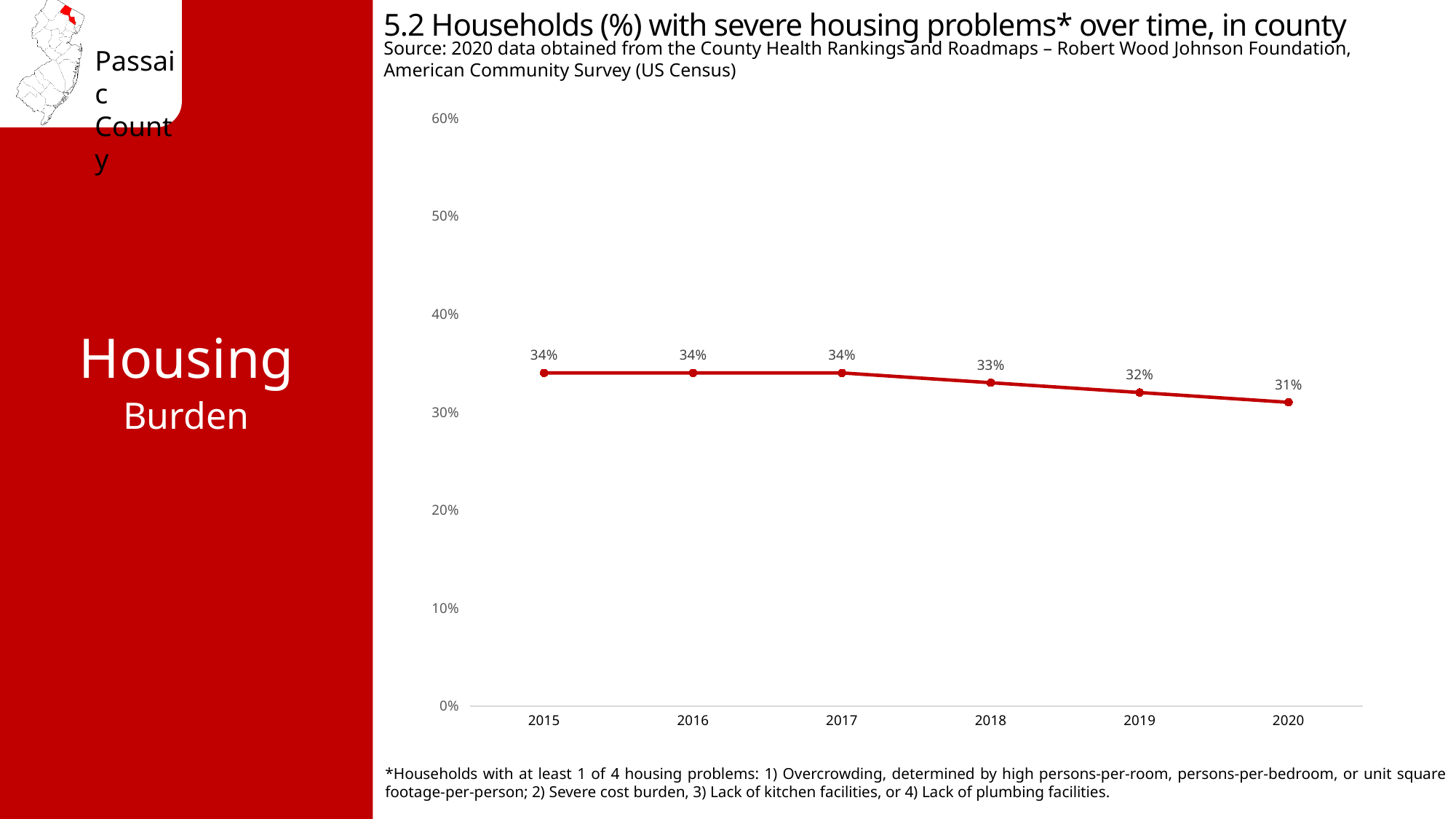
Do the values rise or fall from 2017 to 2020? fall What is the title of the chart? 5.2 Households (%) with severe housing problems* over time, in county How many years are plotted on the chart? 6 What is the value shown for 2018? 33% What is the difference between the 2015 value and the 2020 value? 3% Which year has the lowest percentage of households with severe housing problems? 2020 What is the value shown for 2020? 31% What kind of chart is shown on the slide? line chart Which is larger, the value for 2018 or the value for 2020? 2018 What is the value shown for 2019? 32% Is the value for 2017 greater or less than 30%? greater What percentage of households had severe housing problems in 2015? 34%